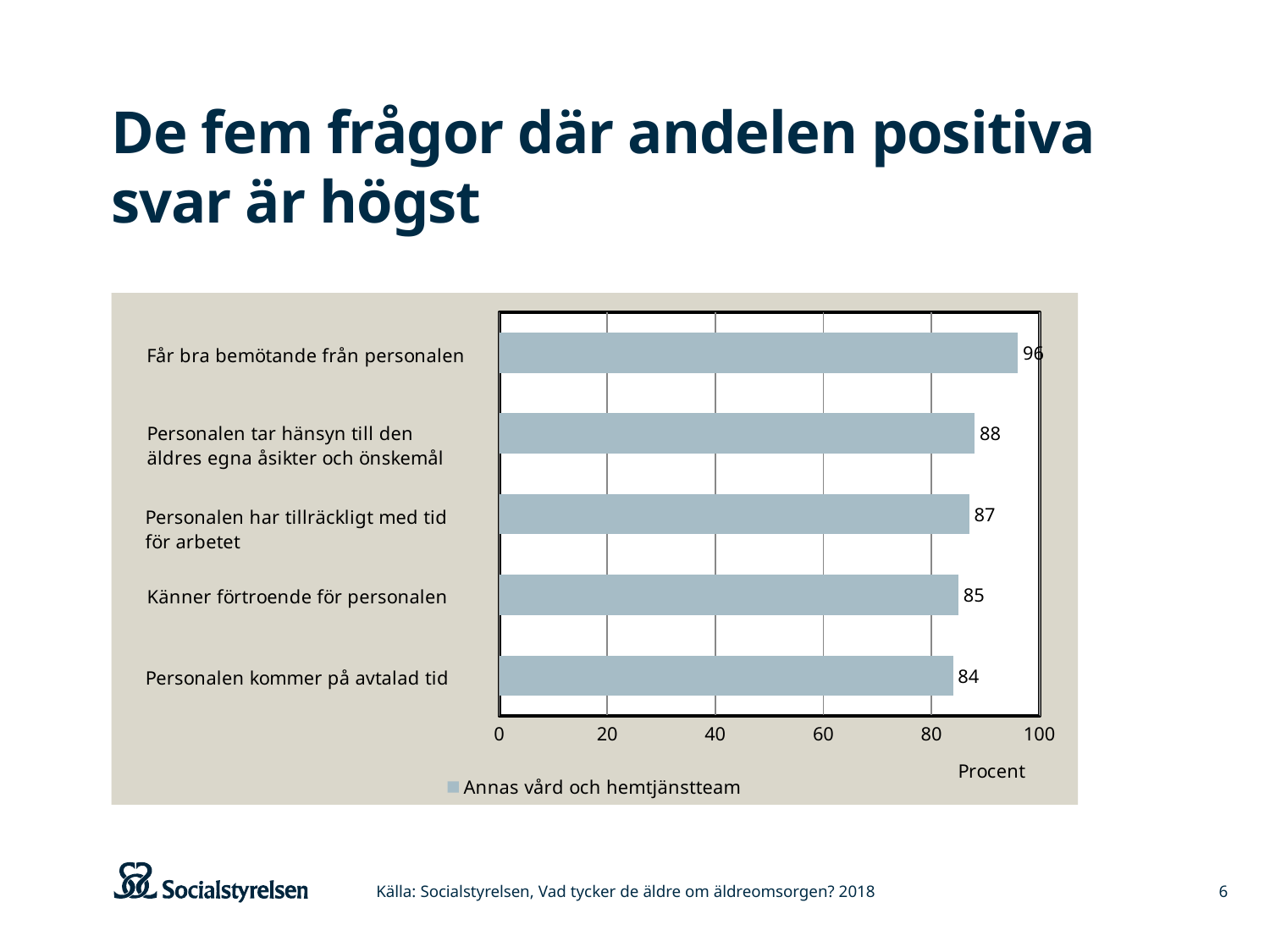
How many categories are shown in the chart? 5 What is the value for "Personalen kommer på avtalad tid"? 84 What is the value for "Får bra bemötande från personalen"? 96 What is the value for "Känner förtroende för personalen"? 85 Which category has the highest value? Får bra bemötande från personalen Which category has the lowest value? Personalen kommer på avtalad tid What is the difference between the values for "Får bra bemötande från personalen" and "Personalen kommer på avtalad tid"? 12 Is the value for "Personalen kommer på avtalad tid" greater or less than 80? greater What kind of chart is shown on the slide? bar chart What is the value for "Personalen har tillräckligt med tid för arbetet"? 87 What series name does the legend show? Annas vård och hemtjänstteam Which is larger: the value for "Personalen tar hänsyn till den äldres egna åsikter och önskemål" or for "Känner förtroende för personalen"? Personalen tar hänsyn till den äldres egna åsikter och önskemål